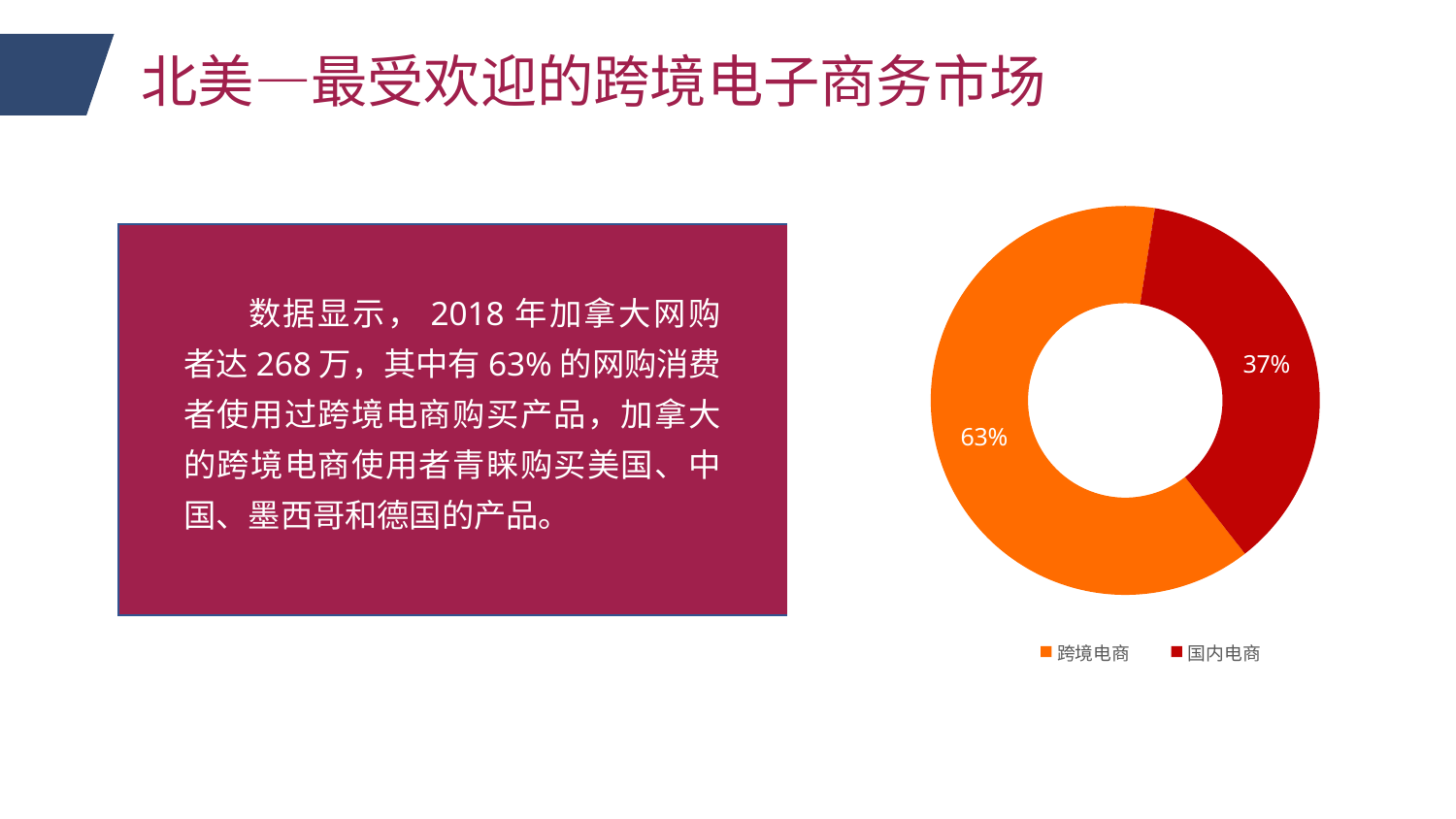
What is the value shown for 国内电商 in the doughnut chart? 37% What share of the doughnut does the 国内电商 slice represent? 37% How many categories are shown in the doughnut chart? 2 What type of chart is shown on the slide? Doughnut chart What colour is the 跨境电商 slice in the doughnut chart? Orange What colour is the 国内电商 slice in the doughnut chart? Red How many entries does the chart legend list? 2 Which is larger, the share for 跨境电商 or the share for 国内电商? 跨境电商 What is the value shown for 跨境电商 in the doughnut chart? 63% What is the difference between the shares of 跨境电商 and 国内电商? 26% Which category has the smallest share in the doughnut chart? 国内电商 Which category has the largest share in the doughnut chart? 跨境电商